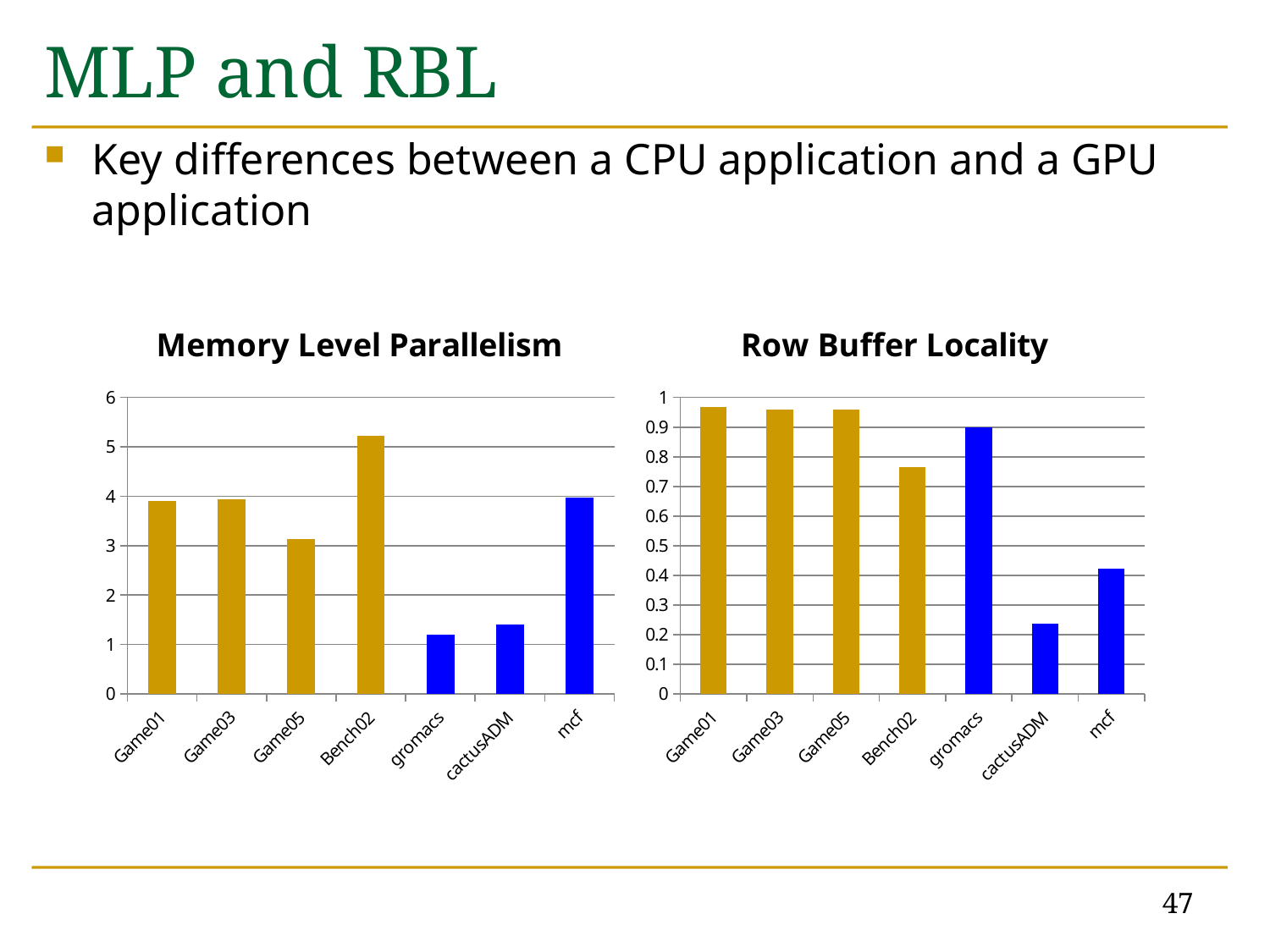
What kind of chart is the Row Buffer Locality chart? bar chart In the Memory Level Parallelism chart, what colour are the bars for gromacs, cactusADM and mcf? blue In the Row Buffer Locality chart, is the value for cactusADM greater or less than 0.3? less In the Row Buffer Locality chart, is the value for Bench02 greater or less than 0.8? less In the Memory Level Parallelism chart, which is larger, the value for Bench02 or the value for Game05? Bench02 In the Memory Level Parallelism chart, is the value for Game05 greater or less than 4? less In the Row Buffer Locality chart, which is larger, the value for gromacs or the value for mcf? gromacs In the Row Buffer Locality chart, which category has the lowest value? cactusADM In the Memory Level Parallelism chart, which category has the highest value? Bench02 How many categories are shown on the x axis of the Memory Level Parallelism chart? 7